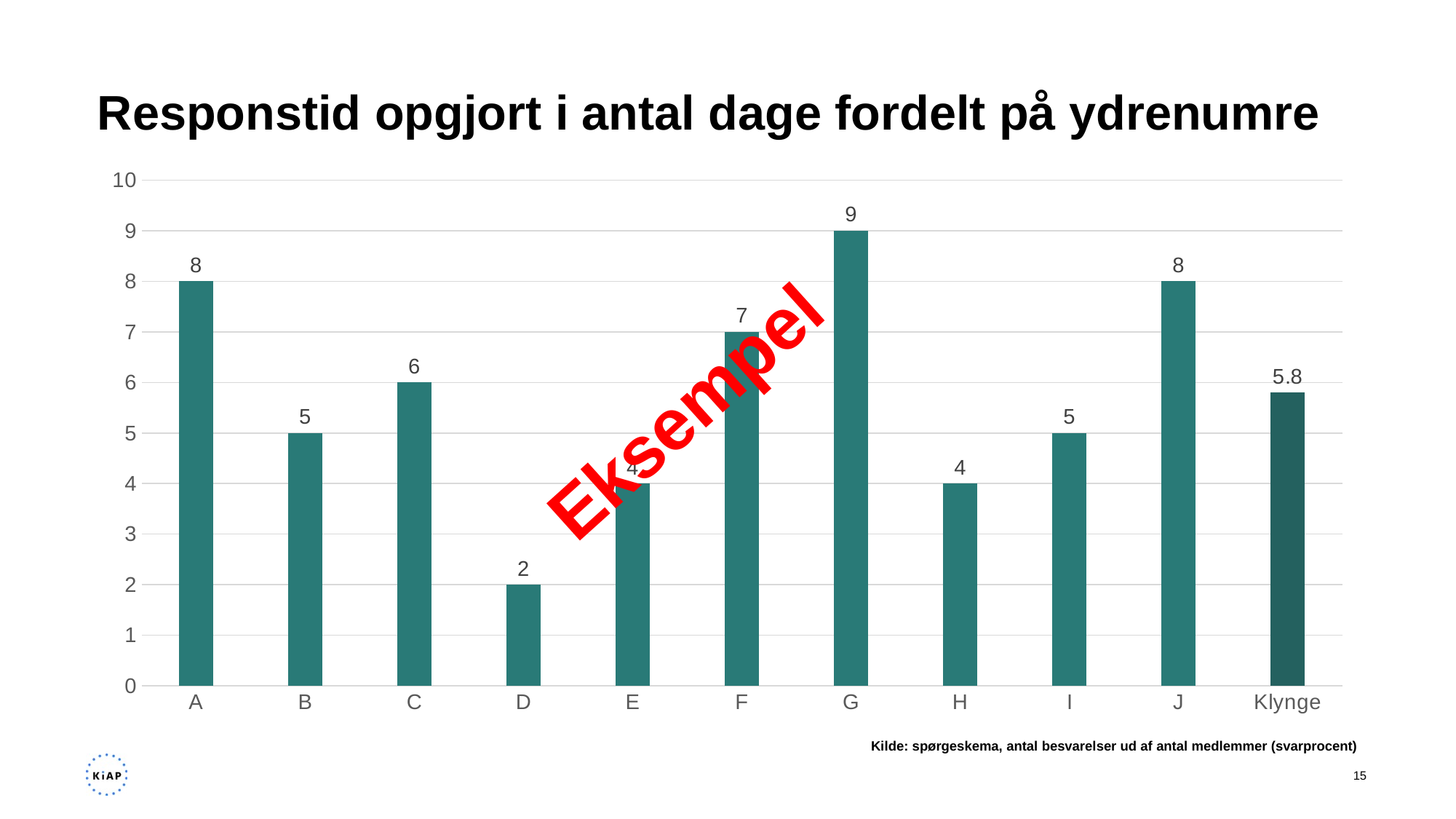
What is the title of the chart? Responstid opgjort i antal dage fordelt på ydrenumre What is the value for D? 2 How many categories are shown on the x axis? 11 What is the value for E? 4 Is the value for F greater or less than 5? greater What is the difference between the values for G and D? 7 What kind of chart is shown on the slide? bar chart Which category has the highest value? G What is the value for G? 9 Which category has the lowest value? D Which is larger, the value for C or the value for H? C What is the value for Klynge? 5.8